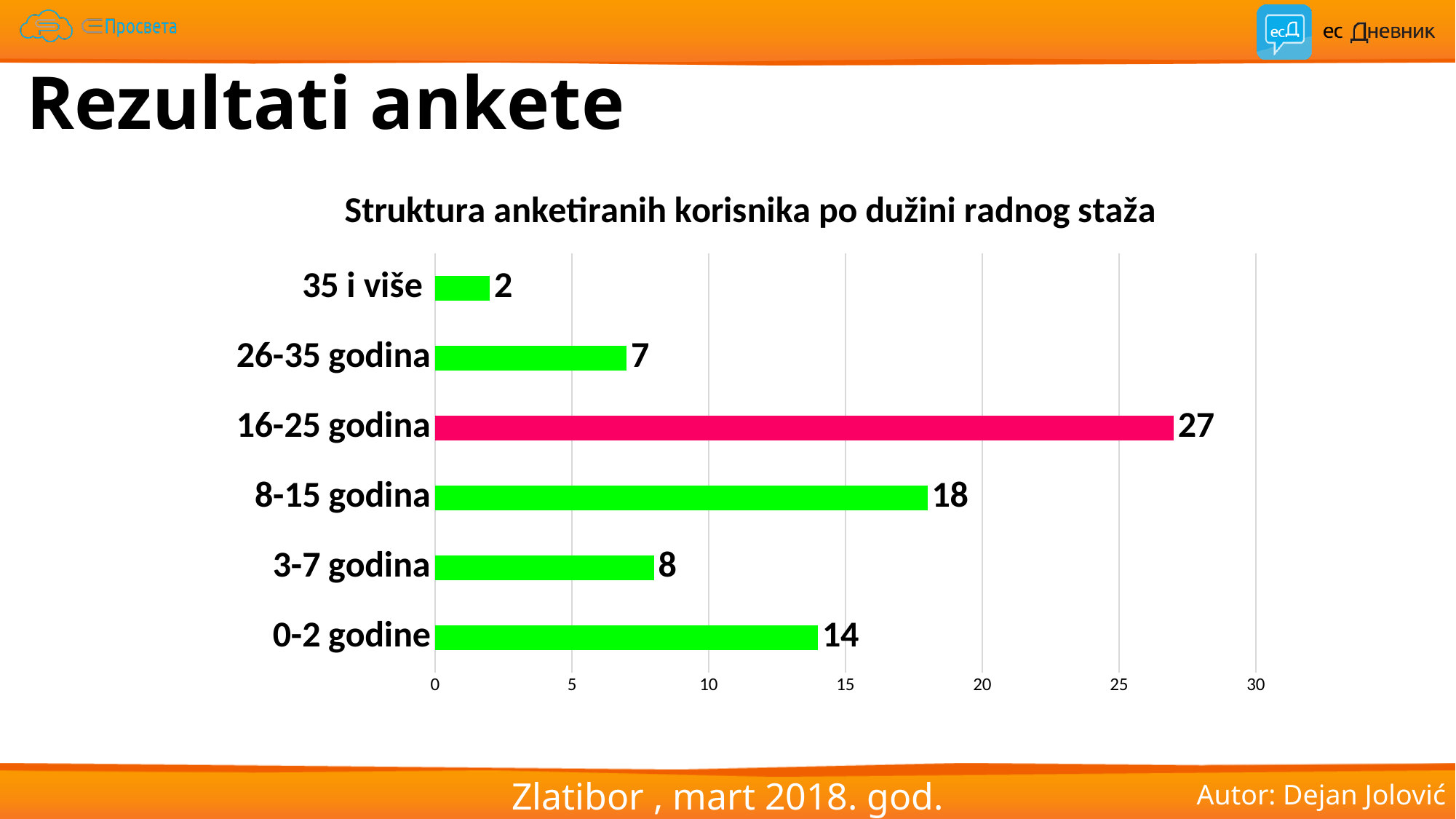
Is the value for 8-15 godina greater or less than 15? greater What is the value for the 0-2 godine category? 14 Which category has the lowest value? 35 i više What is the title of the chart? Struktura anketiranih korisnika po dužini radnog staža What is the value for the 35 i više category? 2 What is the difference between the values for 16-25 godina and 8-15 godina? 9 Which is larger, the value for 3-7 godina or the value for 26-35 godina? 3-7 godina How many categories are shown in the chart? 6 What kind of chart is shown on the slide? bar chart Which category's bar is coloured differently (pink) from the others? 16-25 godina What is the value for the 16-25 godina category? 27 Which category has the highest value? 16-25 godina